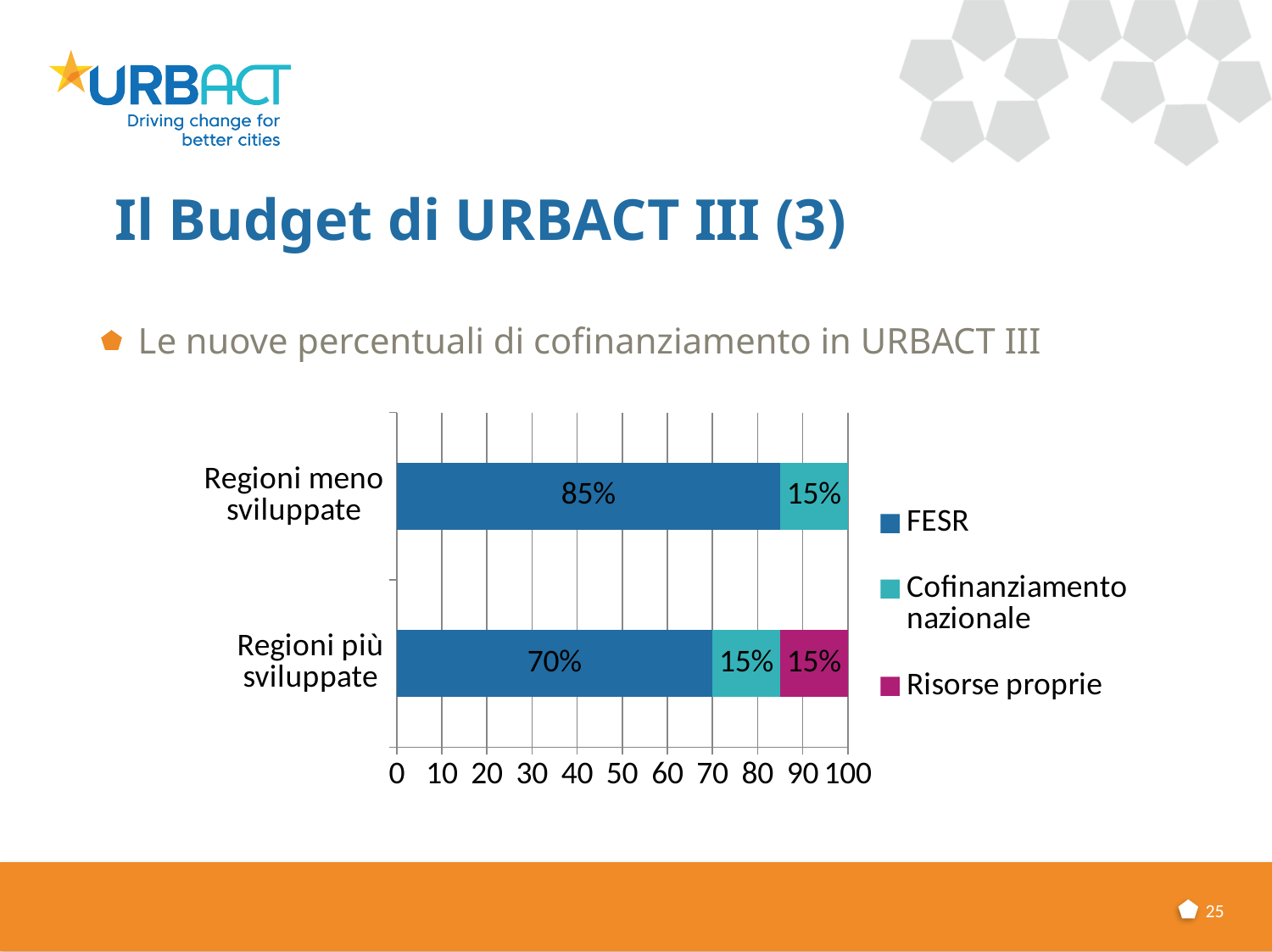
What is the FESR value for Regioni più sviluppate? 70% What is the FESR value for Regioni meno sviluppate? 85% What is the Cofinanziamento nazionale value for Regioni più sviluppate? 15% Is the FESR value for Regioni più sviluppate larger or smaller than the FESR value for Regioni meno sviluppate? smaller Which category has the higher FESR value? Regioni meno sviluppate What is the Risorse proprie value for Regioni più sviluppate? 15% What is the difference between the FESR values for Regioni meno sviluppate and Regioni più sviluppate? 15% How many series does the legend list? 3 How many categories are shown on the chart? 2 Which series is shown in magenta in the legend? Risorse proprie What is the total of the stacked bar for Regioni più sviluppate? 100% What kind of chart is shown on the slide? stacked bar chart